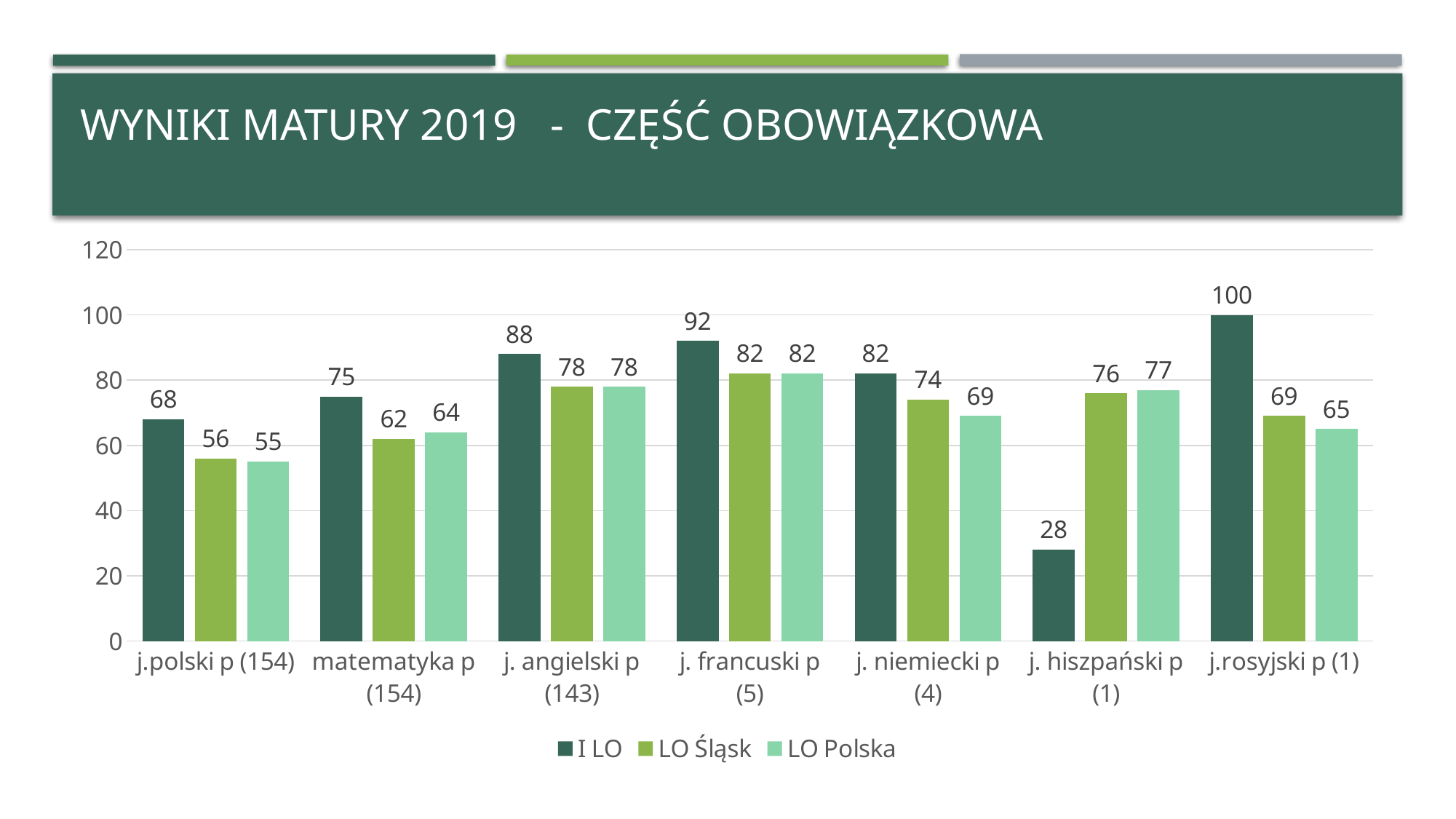
What is the I LO value for j. angielski p (143)? 88 How many categories are shown on the x axis? 7 What kind of chart is shown on the slide? bar chart Is the I LO value for j. hiszpański p (1) greater or less than 40? less Which category has the lowest I LO value? j. hiszpański p (1) What is the LO Polska value for matematyka p (154)? 64 What is the LO Śląsk value for j. hiszpański p (1)? 76 What is the title of the slide? WYNIKI MATURY 2019 - CZĘŚĆ OBOWIĄZKOWA Which is larger for j. niemiecki p (4): the LO Śląsk value or the LO Polska value? LO Śląsk Which category has the highest I LO value? j.rosyjski p (1) How many series does the legend list? 3 What is the difference between the I LO and LO Śląsk values for j.polski p (154)? 12